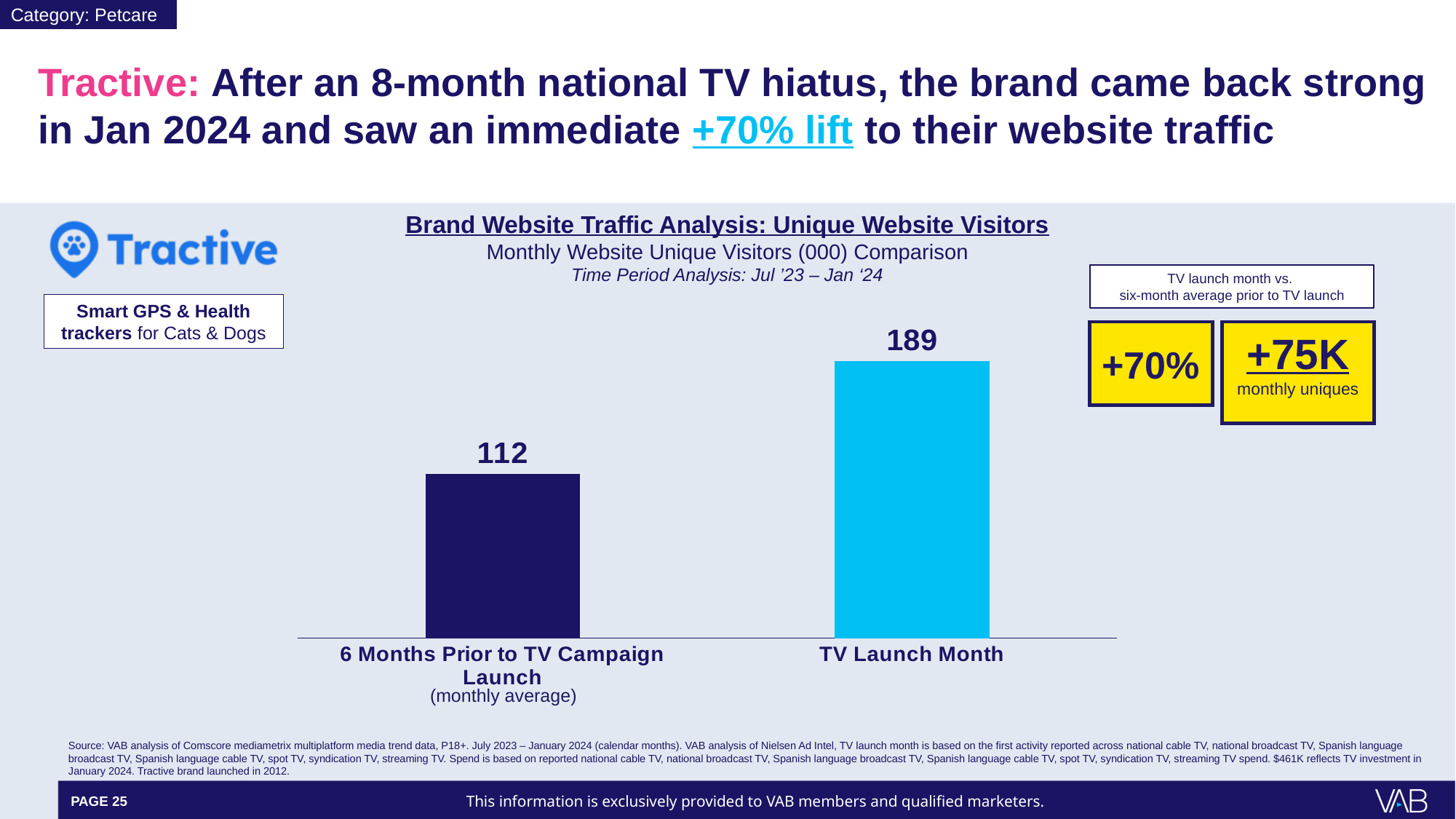
What is the value for 6 Months Prior to TV Campaign Launch? 112 Which category has the highest value? TV Launch Month Which is larger, the value for TV Launch Month or the value for 6 Months Prior to TV Campaign Launch? TV Launch Month How many bars are shown in the chart? 2 What kind of chart is shown on the slide? Bar chart What percentage lift is shown in the callout box comparing TV launch month to the six-month average prior to TV launch? +70% Do the values rise or fall from the left bar to the right bar? Rise What is the difference between the TV Launch Month value and the 6 Months Prior to TV Campaign Launch value? 77 Which category has the lowest value? 6 Months Prior to TV Campaign Launch What is the value for TV Launch Month? 189 What time period does the chart's subtitle say is analyzed? Jul '23 – Jan '24 What is the title of the chart? Brand Website Traffic Analysis: Unique Website Visitors